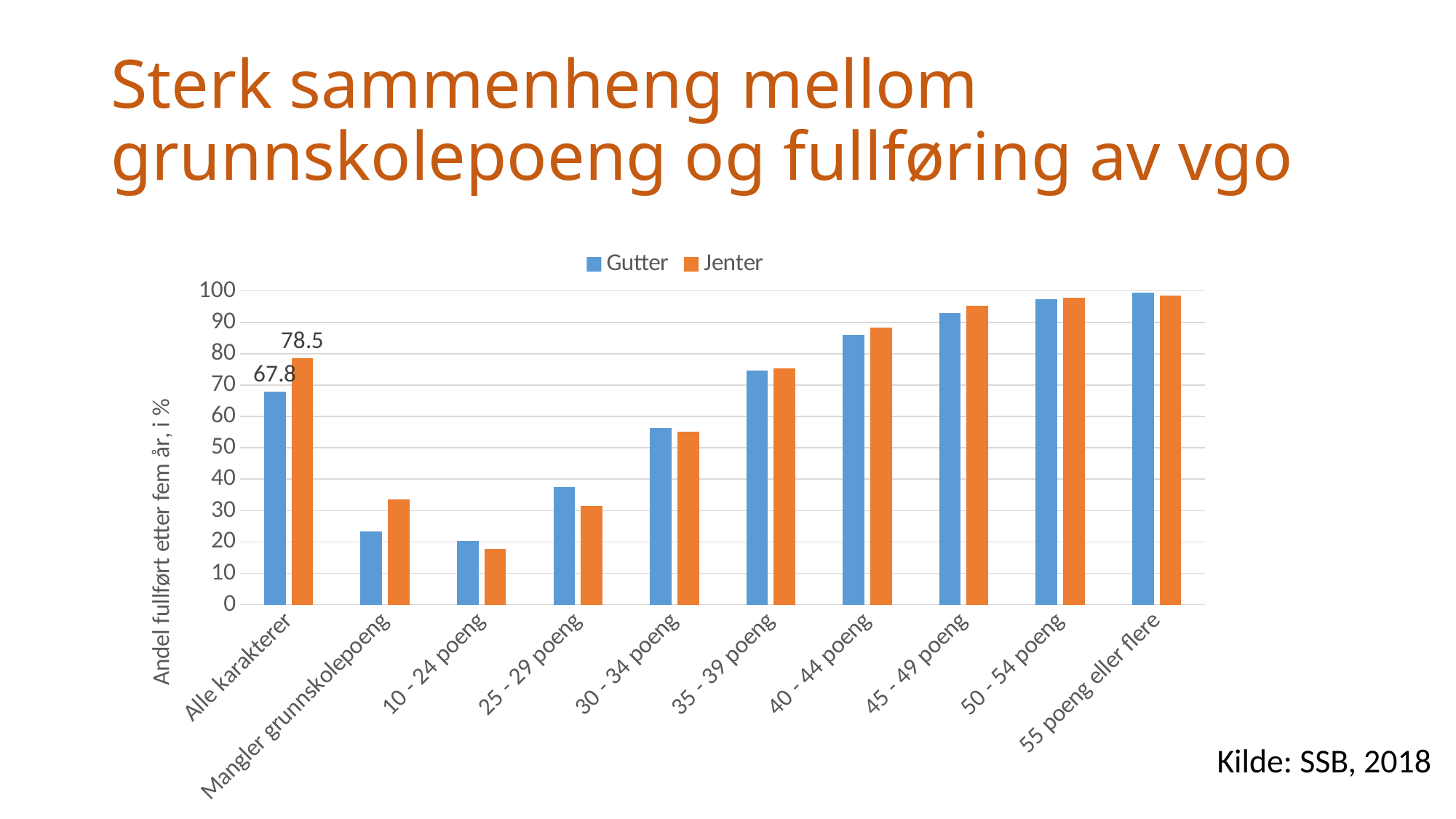
In the Alle karakterer category, which series has the larger value, Gutter or Jenter? Jenter How many series does the legend list? 2 In the Alle karakterer category, what is the difference between the Jenter and Gutter values? 10.7 What is the label of the vertical axis? Andel fullført etter fem år, i % Is the Jenter value for 25 - 29 poeng greater or less than 40? less How many categories are shown on the x axis? 10 In the Mangler grunnskolepoeng category, which series has the larger value, Gutter or Jenter? Jenter Is the Gutter value for 30 - 34 poeng greater or less than 50? greater What kind of chart is shown on the slide? bar chart For which category is the Jenter value lowest? 10 - 24 poeng What is the value for Gutter in the Alle karakterer category? 67.8 What is the value for Jenter in the Alle karakterer category? 78.5